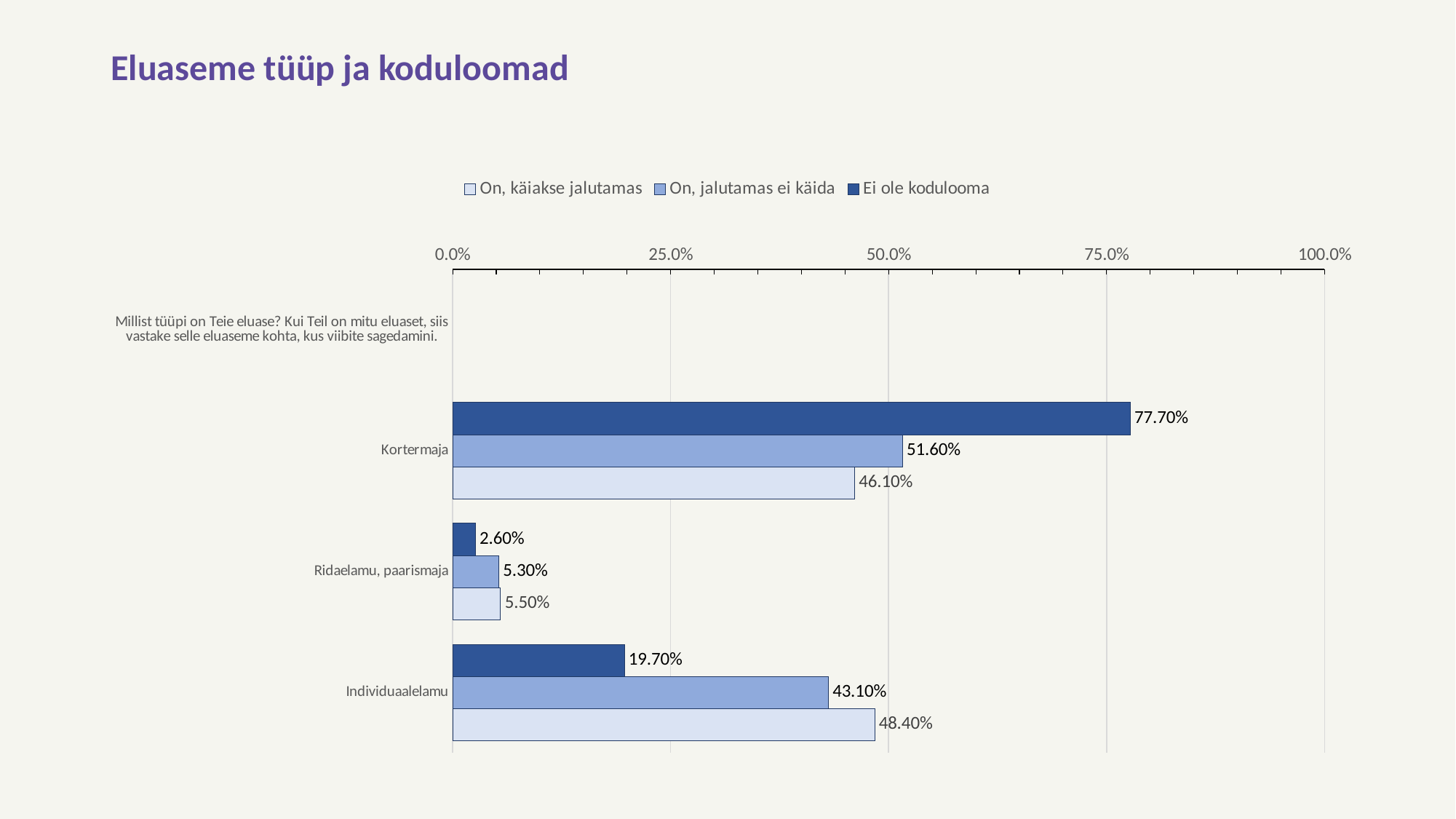
Is the "Ei ole kodulooma" value for Kortermaja greater or less than 75.0%? greater What is the title of the slide? Eluaseme tüüp ja koduloomad What kind of chart is shown on the slide? Bar chart Which category has the highest value for "Ei ole kodulooma"? Kortermaja What is the difference between the "Ei ole kodulooma" and "On, jalutamas ei käida" values for Kortermaja? 26.10% How many housing-type categories are shown on the chart? 3 Which is larger for Individuaalelamu: "On, käiakse jalutamas" or "Ei ole kodulooma"? On, käiakse jalutamas Which category has the lowest value for "On, käiakse jalutamas"? Ridaelamu, paarismaja What is the value for "On, jalutamas ei käida" in the Ridaelamu, paarismaja category? 5.30% What is the value for "Ei ole kodulooma" in the Kortermaja category? 77.70% How many series does the legend list? 3 What is the value for "On, käiakse jalutamas" in the Individuaalelamu category? 48.40%